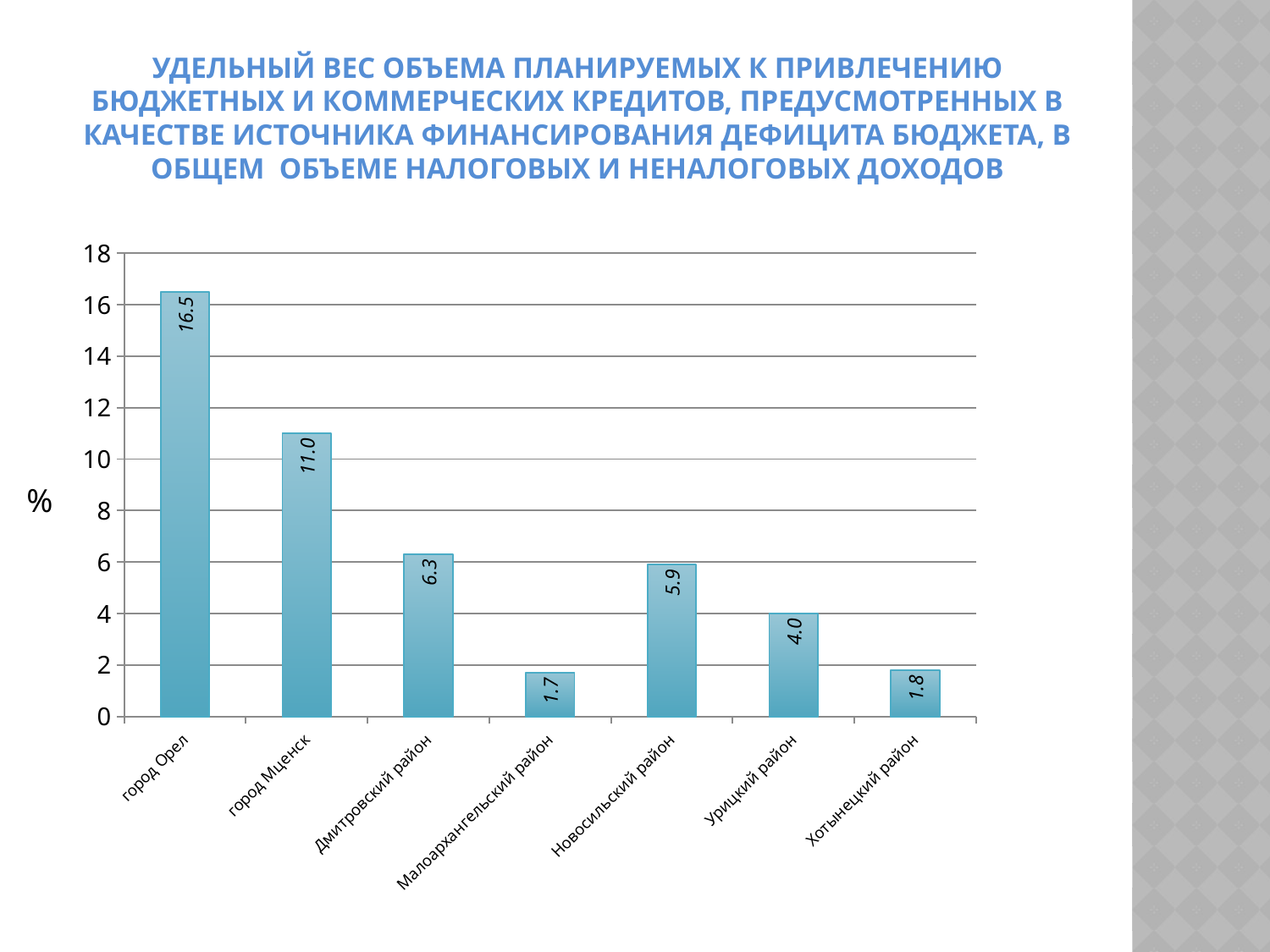
Which category has the lowest value? Малоархангельский район What is the difference between the values for Хотынецкий район and Малоархангельский район? 0.1 What is the value for город Орел? 16.5 What unit label is shown on the vertical axis? % Which is larger, the value for Дмитровский район or the value for Новосильский район? Дмитровский район What is the difference between the values for город Орел and город Мценск? 5.5 What is the value for Новосильский район? 5.9 What kind of chart is shown on the slide? bar chart How many categories are shown on the x axis? 7 Which category has the highest value? город Орел Is the value for город Мценск greater or less than 10? greater What is the value for Урицкий район? 4.0